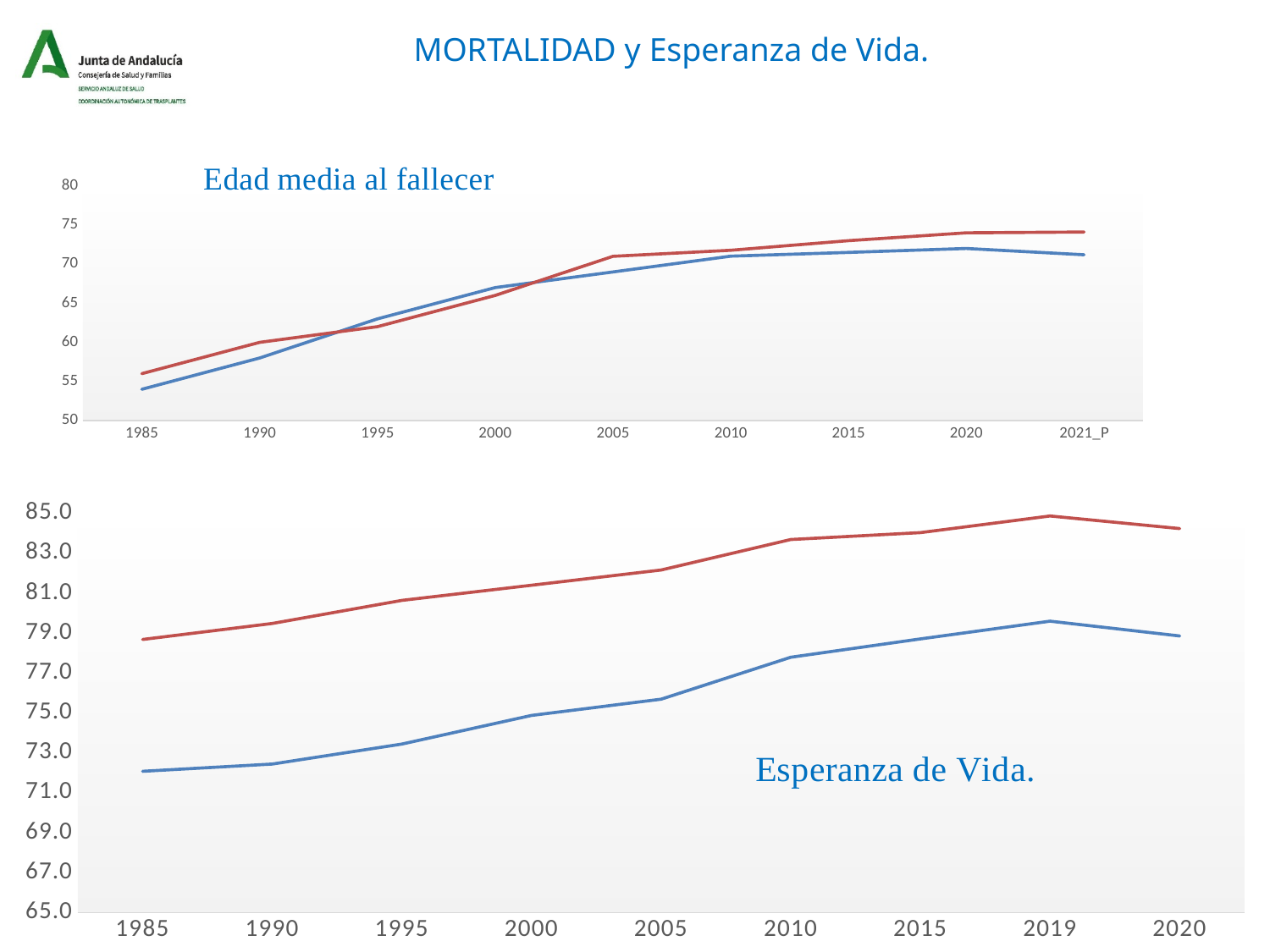
In the 'Esperanza de Vida.' chart, in which year does the red line reach its highest value? 2019 In the 'Esperanza de Vida.' chart, how many years are shown on the x axis? 9 In the 'Esperanza de Vida.' chart, is the value of the red line for 2019 greater or less than 83.0? greater In the 'Edad media al fallecer' chart, is the value of the red line for 1985 greater or less than 55? greater What kind of chart is the 'Esperanza de Vida.' chart? line chart What kind of chart is the 'Edad media al fallecer' chart? line chart In the 'Esperanza de Vida.' chart, which line is higher in 2019, the red line or the blue line? the red line In the 'Edad media al fallecer' chart, is the value of the red line for 2020 greater or less than 75? less In the 'Edad media al fallecer' chart, how many years are shown on the x axis? 9 In the 'Esperanza de Vida.' chart, do the values of the blue line generally rise or fall from 1985 to 2019? rise